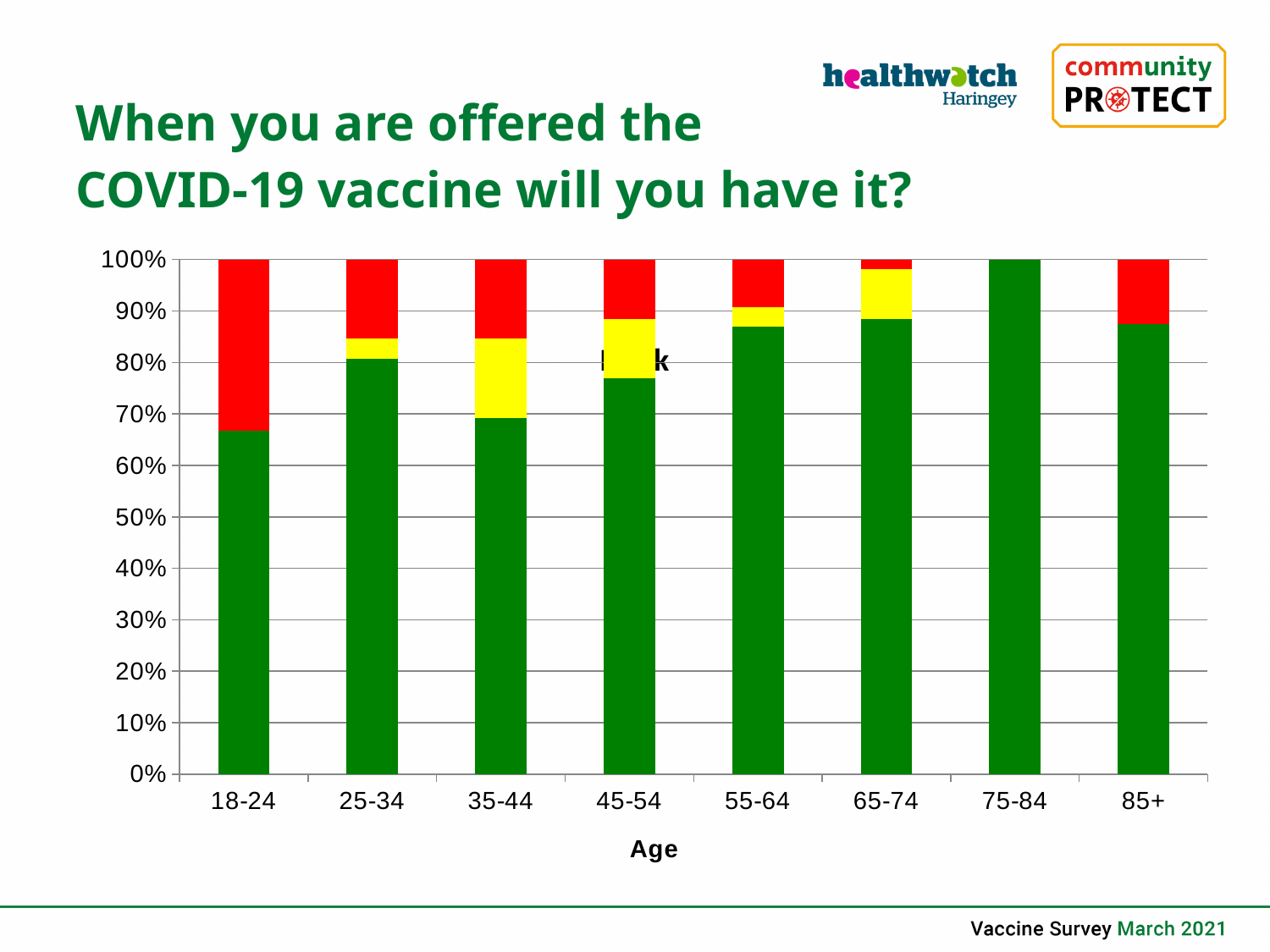
What kind of chart is shown on the slide? stacked bar chart Which age group has the largest red segment? 18-24 Which age group has the largest yellow segment? 35-44 Is the green segment for 18-24 greater or less than 70%? less Is the green segment for 55-64 greater or less than 80%? greater What is the title of the x axis? Age What is the total height of the 18-24 stacked bar? 100% How many age categories are shown on the x axis? 8 Is the green segment larger for 18-24 or for 65-74? 65-74 Is the green segment for 45-54 greater or less than 80%? less Which age group has the largest green segment? 75-84 Which age group has the smallest green segment? 18-24